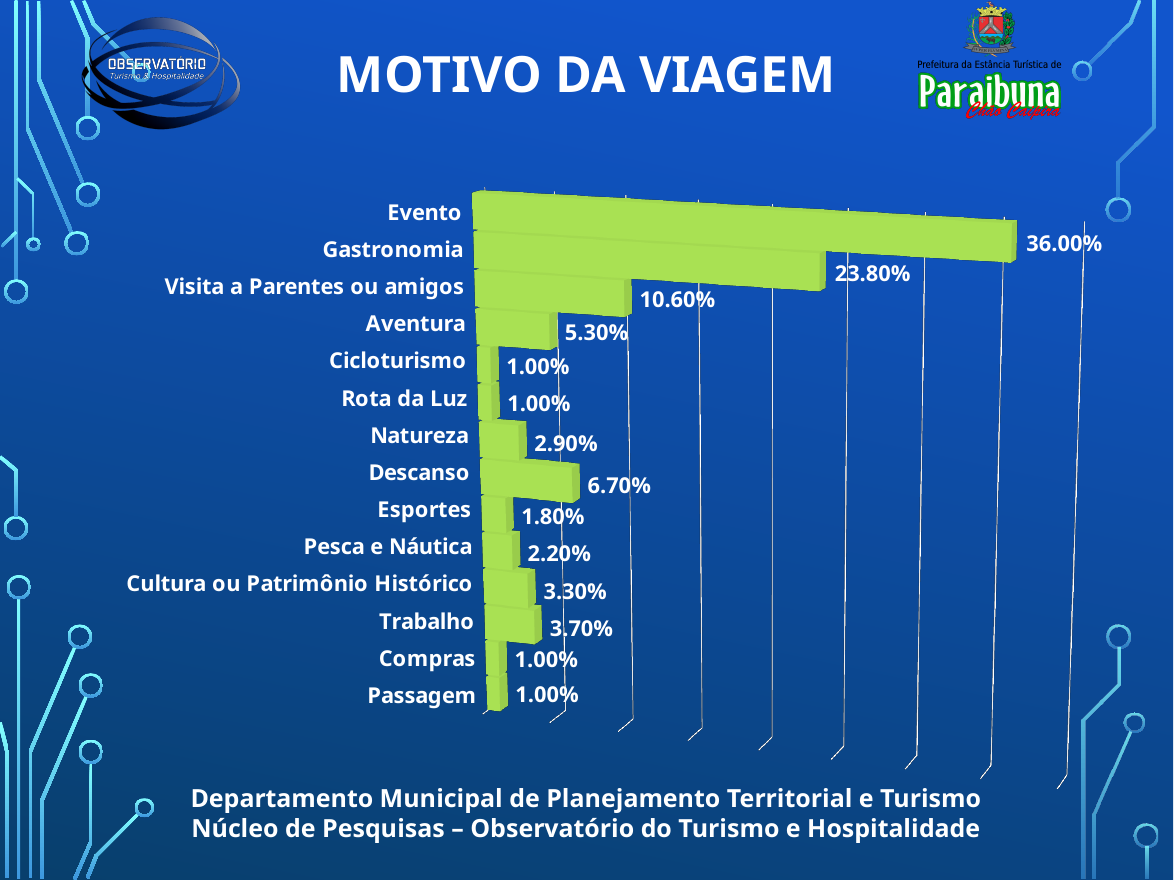
What is the difference between the values for Visita a Parentes ou amigos and Aventura? 5.30% What is the value for Evento? 36.00% Which is larger, the value for Natureza or the value for Cultura ou Patrimônio Histórico? Cultura ou Patrimônio Histórico What is the value for Descanso? 6.70% How many categories are shown in the chart? 14 Which is larger, the value for Descanso or the value for Aventura? Descanso What is the value for Gastronomia? 23.80% What is the value for Trabalho? 3.70% Which category has the highest value? Evento What kind of chart is shown on the slide? Bar chart What is the title of the chart? MOTIVO DA VIAGEM What is the difference between the values for Evento and Gastronomia? 12.20%